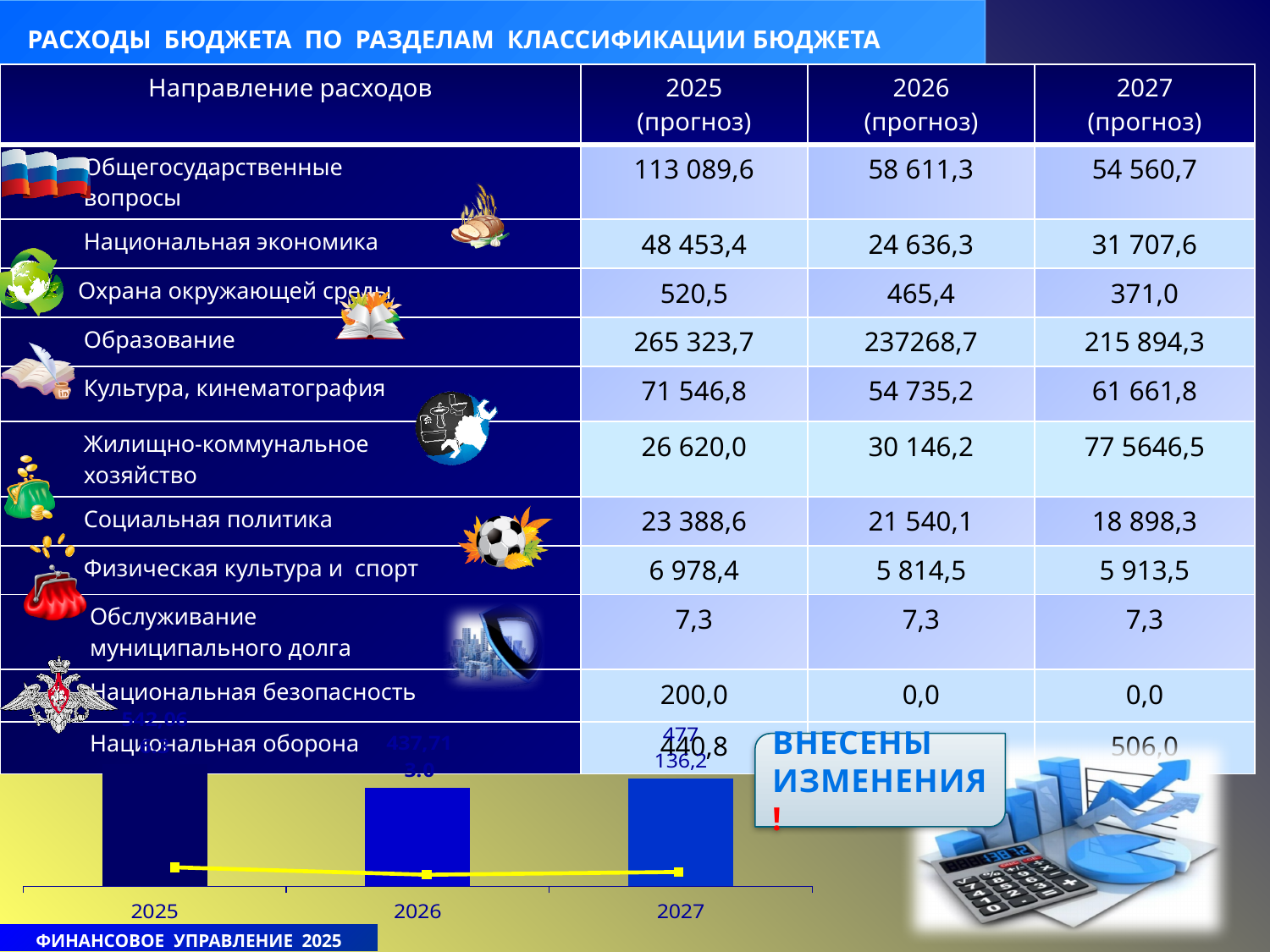
What kind of chart is shown at the bottom of the slide? bar chart with a line How many years are shown on the x axis of the chart at the bottom of the slide? 3 In the chart at the bottom of the slide, does the yellow line rise or fall from 2025 to 2026? fall In the chart at the bottom of the slide, is the yellow line higher in 2025 or in 2027? 2025 Which years are labelled on the x axis of the chart at the bottom of the slide? 2025, 2026, 2027 In the chart at the bottom of the slide, in which year is the yellow line at its highest point? 2025 What colour are the bars in the chart at the bottom of the slide? blue